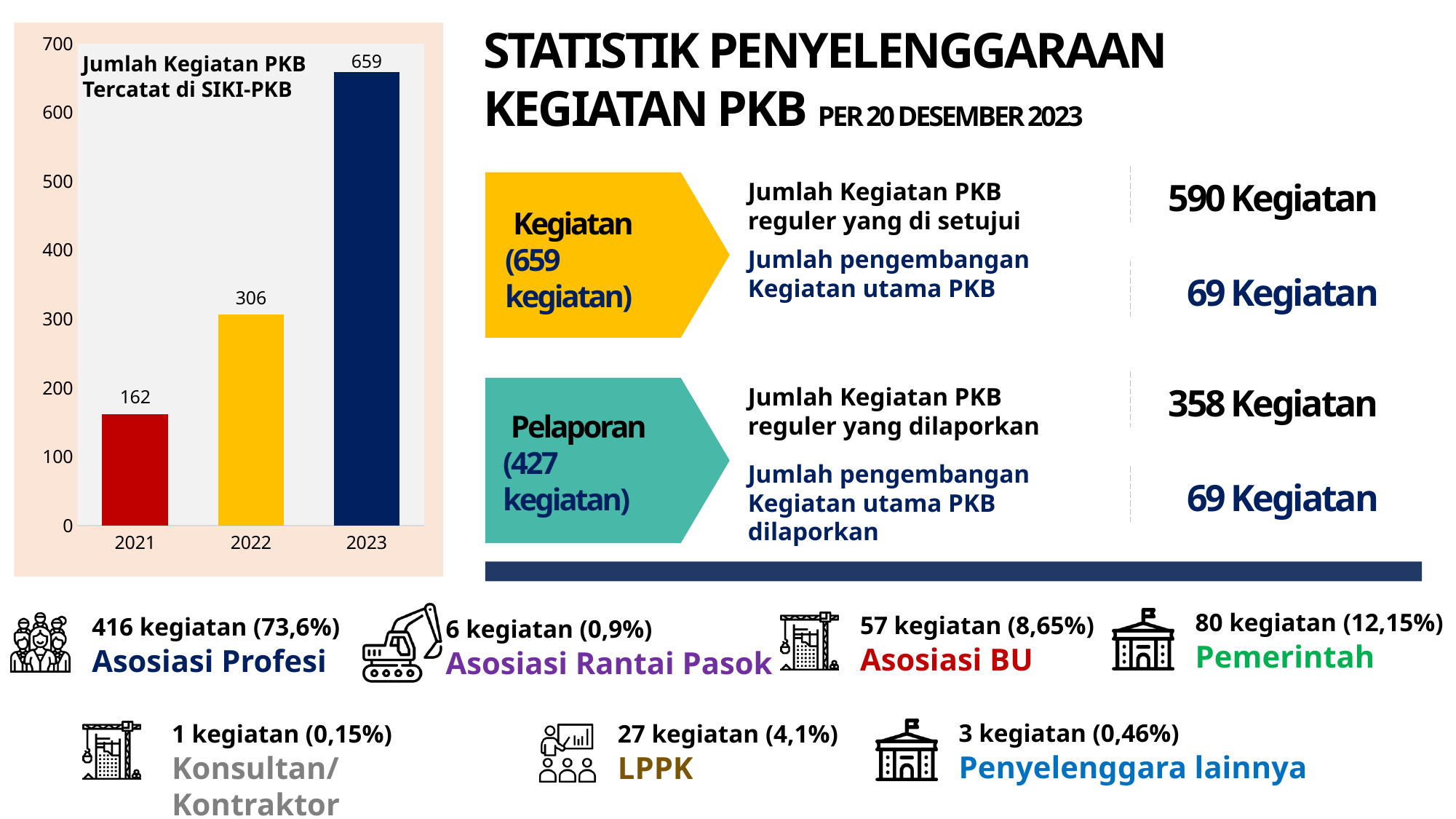
What is the difference between the values for 2023 and 2022? 353 How many years are shown on the x axis of the chart? 3 What is the value for 2022 in the chart? 306 Do the values rise or fall from 2021 to 2023? rise What is the value for 2023 in the chart? 659 What is the difference between the values for 2022 and 2021? 144 What kind of chart is shown on the slide? bar chart Which year has the highest value in the chart? 2023 Which is larger, the value for 2022 or the value for 2021? 2022 Which year has the lowest value in the chart? 2021 Is the value for 2023 greater or less than 600? greater What is the value for 2021 in the chart? 162